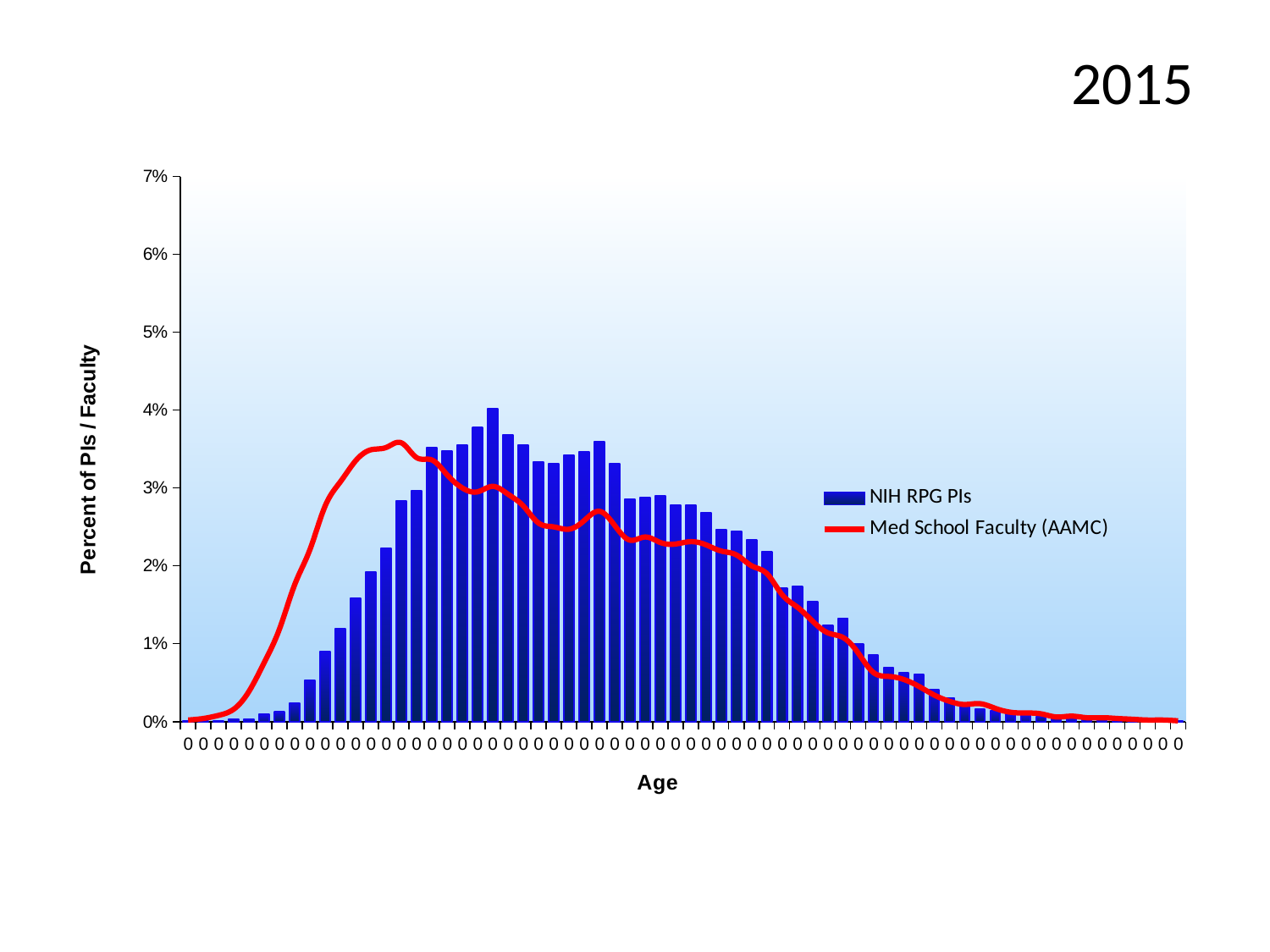
Which series is drawn as a red line? Med School Faculty (AAMC) What year is shown at the top of the slide? 2015 What kind of chart is shown on the slide? A bar chart with a line overlay Is the tallest NIH RPG PIs bar greater or less than 5%? less What are the two series named in the legend? NIH RPG PIs and Med School Faculty (AAMC) Is the tallest NIH RPG PIs bar greater or less than 3%? greater How many series does the legend list? 2 Along the x axis, does the Med School Faculty (AAMC) line reach its peak before or after the NIH RPG PIs bars reach their peak? before Is the peak of the Med School Faculty (AAMC) line greater or less than 4%? less